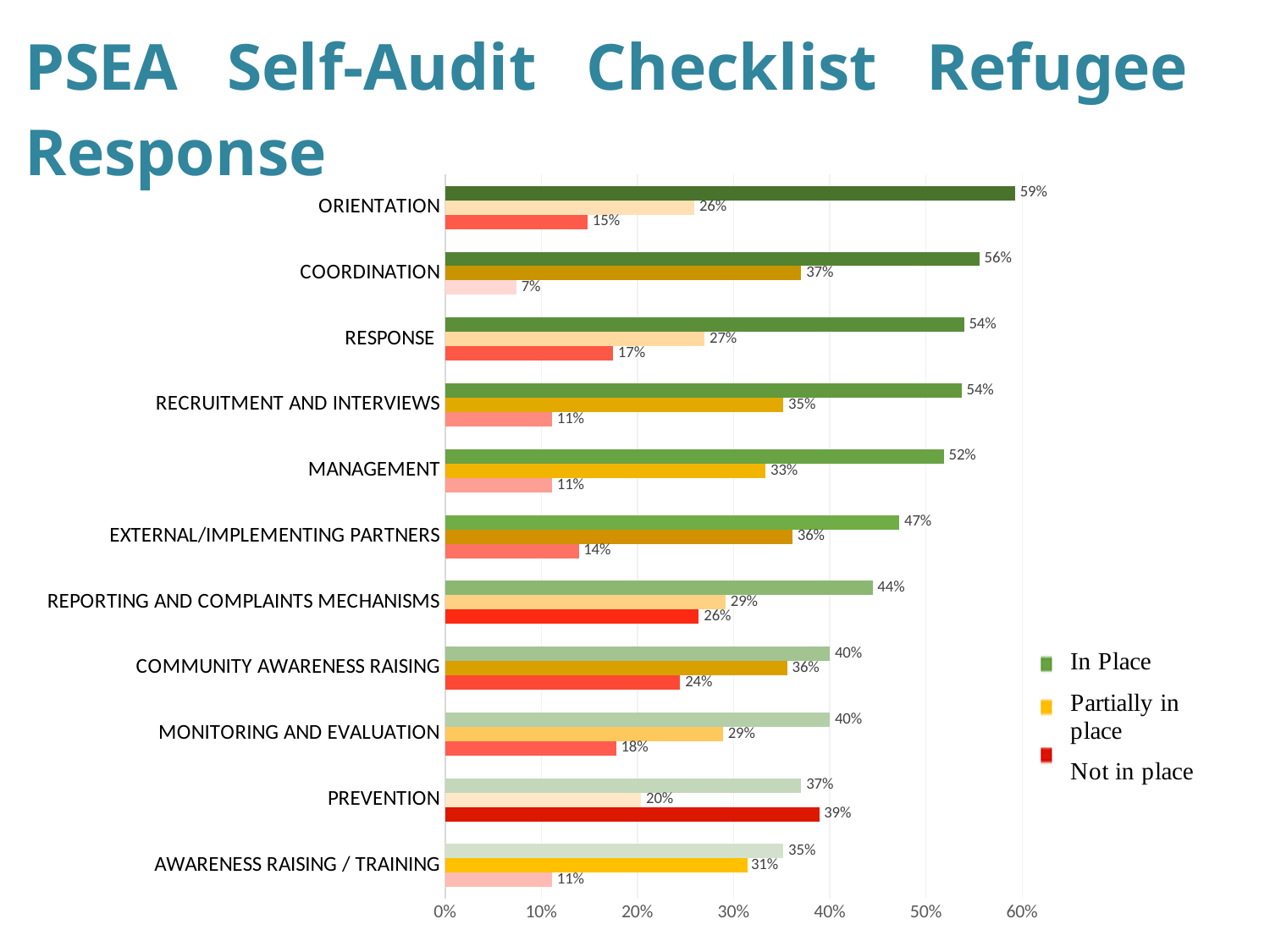
What is the Partially in place value for AWARENESS RAISING / TRAINING? 31% What kind of chart is shown on the slide? Bar chart For PREVENTION, which is larger: the In Place value or the Not in place value? Not in place How many categories are shown on the chart? 11 What is the difference between the In Place and Not in place values for ORIENTATION? 44 percentage points Which category has the highest In Place value? ORIENTATION Which category has the lowest In Place value? AWARENESS RAISING / TRAINING What is the Not in place value for COORDINATION? 7% How many series does the legend list? 3 Is the In Place value for MANAGEMENT greater or less than 50%? greater What is the In Place value for ORIENTATION? 59% Which category has the highest Not in place value? PREVENTION